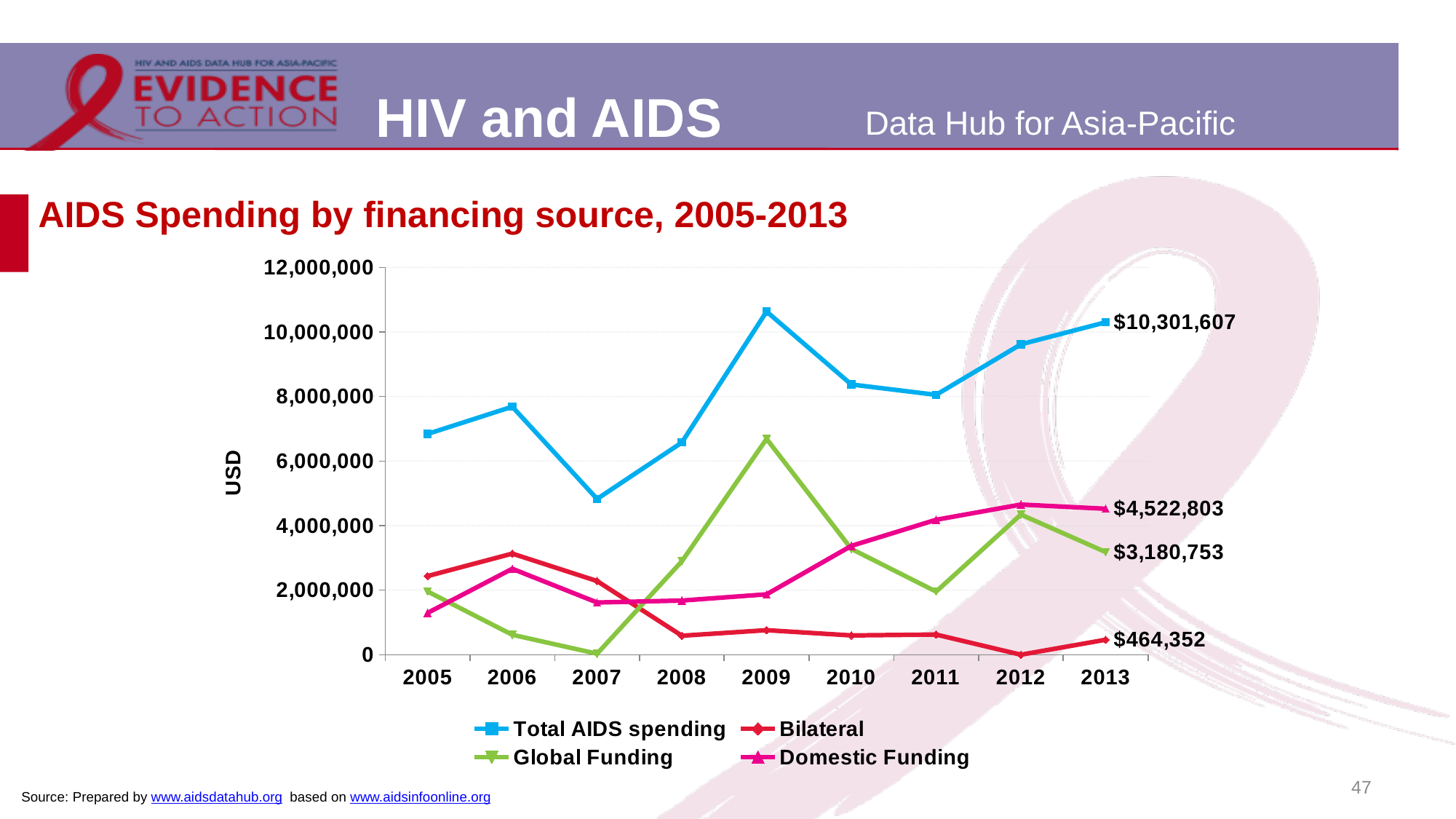
In 2013, which is larger: Domestic Funding or Global Funding? Domestic Funding What is the value of Global Funding in 2013? $3,180,753 What is the value of Bilateral funding in 2013? $464,352 In which year was Total AIDS spending highest? 2009 How many years are shown on the x axis? 9 Is the value for Global Funding in 2009 greater or less than 6,000,000? greater What kind of chart is shown on the slide? Line chart What is the value of Total AIDS spending in 2013? $10,301,607 What is the difference between Domestic Funding and Global Funding in 2013? $1,342,050 What is the value of Domestic Funding in 2013? $4,522,803 How many series does the legend list? 4 In which year was Total AIDS spending lowest? 2007